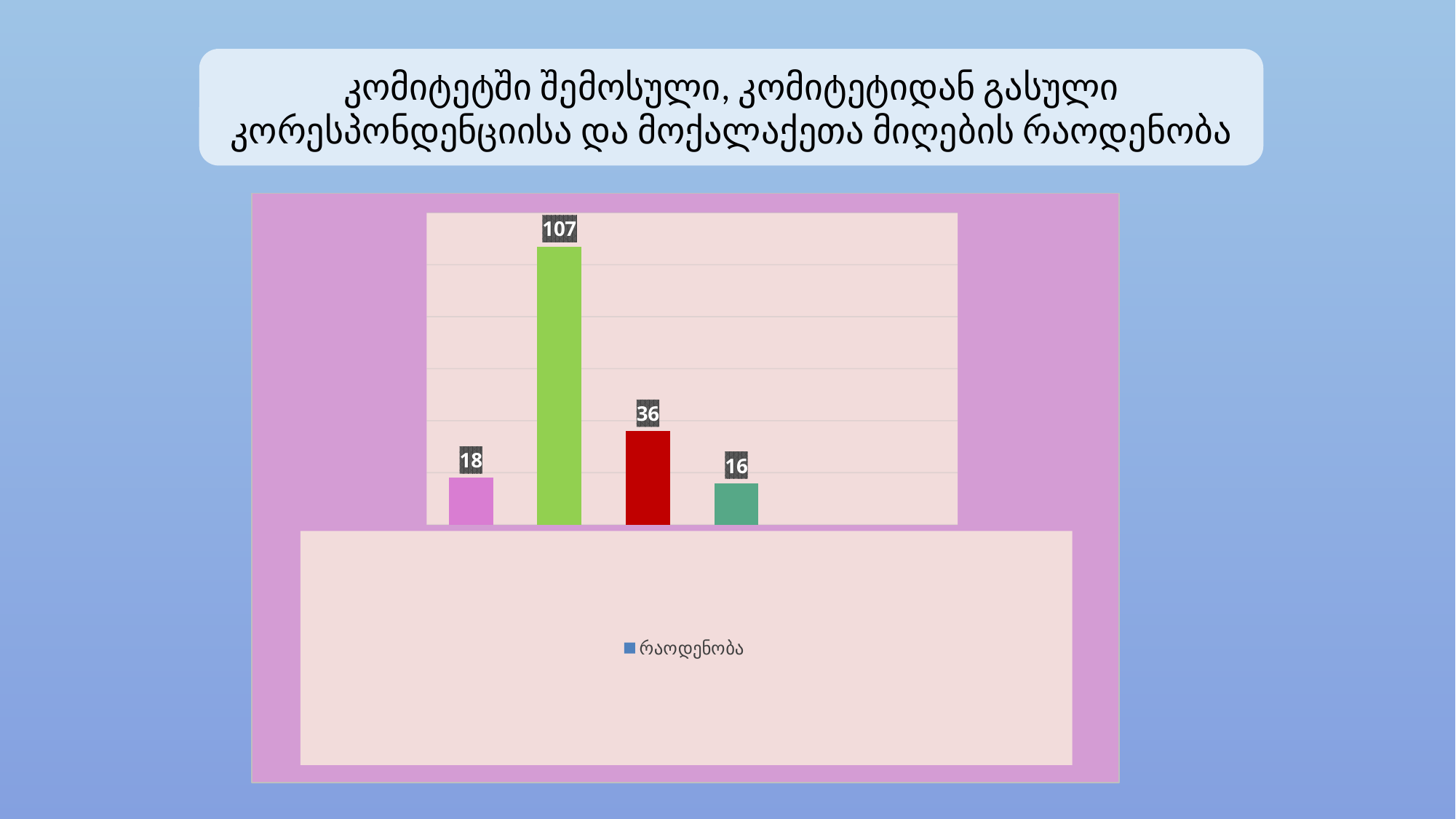
What type of chart is shown on the slide? bar chart Which bar has the lowest value? the teal bar (16) Which bar has the highest value? the green bar (107) How many bars are plotted in the chart? 4 Which is larger, the value of the pink bar or the value of the red bar? the red bar (36) What is the value shown on the green bar? 107 How many series does the chart legend list? 1 What is the difference between the green bar's value and the red bar's value? 71 What is the value shown on the pink (first) bar? 18 What is the value shown on the teal (last) bar? 16 What is the name of the series shown in the chart legend? რაოდენობა What is the value shown on the red bar? 36